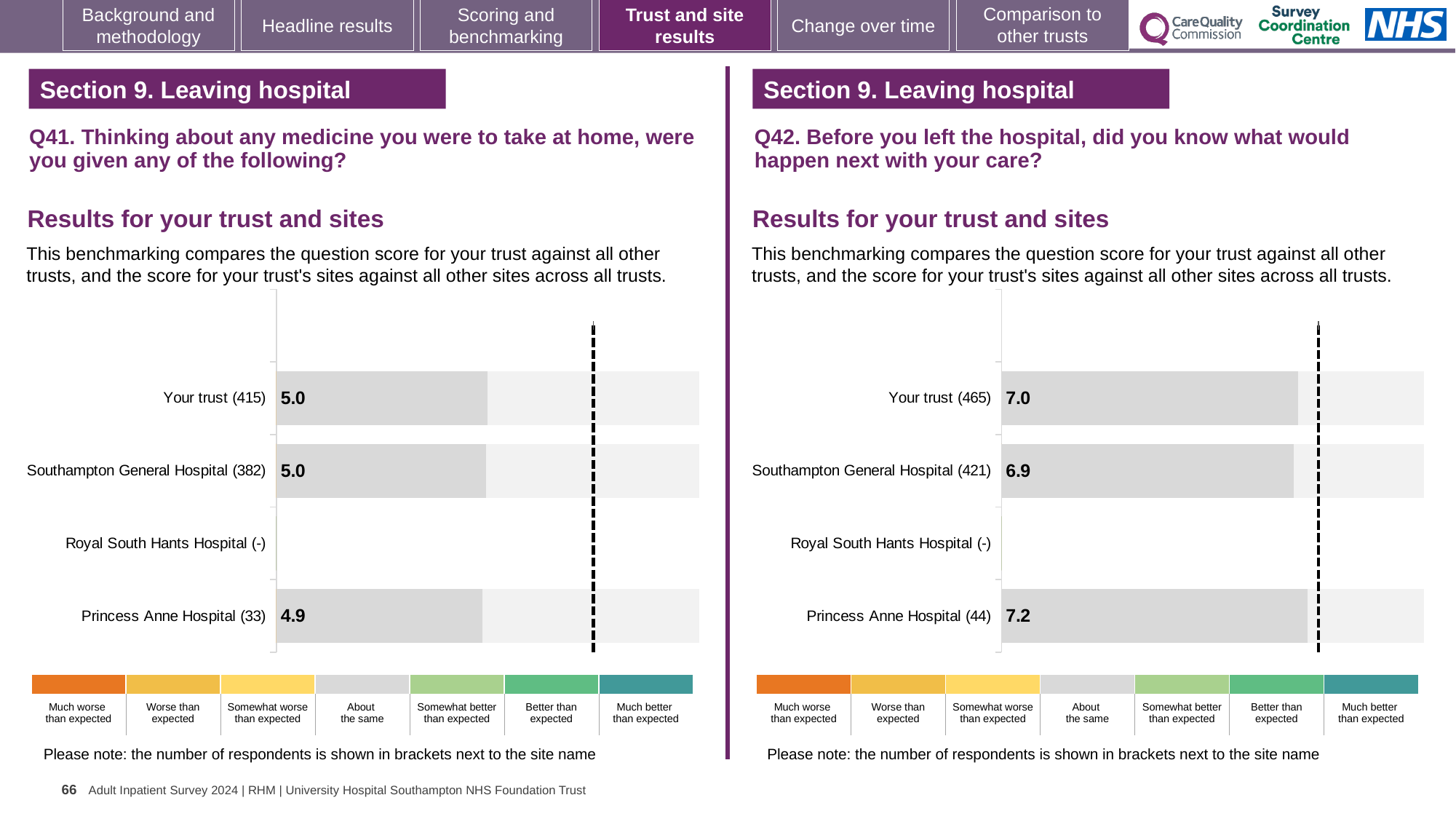
On the Q42 chart (right), what is the difference between the scores for Princess Anne Hospital and Southampton General Hospital? 0.3 On the Q41 chart (left), which is larger: the score for Your trust or the score for Princess Anne Hospital? Your trust On the Q41 chart (left), how many respondents are shown for Southampton General Hospital? 382 On the Q42 chart (right), how many respondents are shown for Your trust? 465 What kind of chart is used on the Q42 chart (right)? Bar chart On the Q41 chart (left), what is the score for Your trust? 5.0 On the Q42 chart (right), what is the score for Princess Anne Hospital? 7.2 On the Q42 chart (right), what is the score for Southampton General Hospital? 6.9 How many rows (sites including Your trust) are listed on the Q41 chart (left)? 4 On the Q42 chart (right), which site has the lowest score? Southampton General Hospital On the Q42 chart (right), which site has the highest score? Princess Anne Hospital On the Q41 chart (left), what is the score for Princess Anne Hospital? 4.9